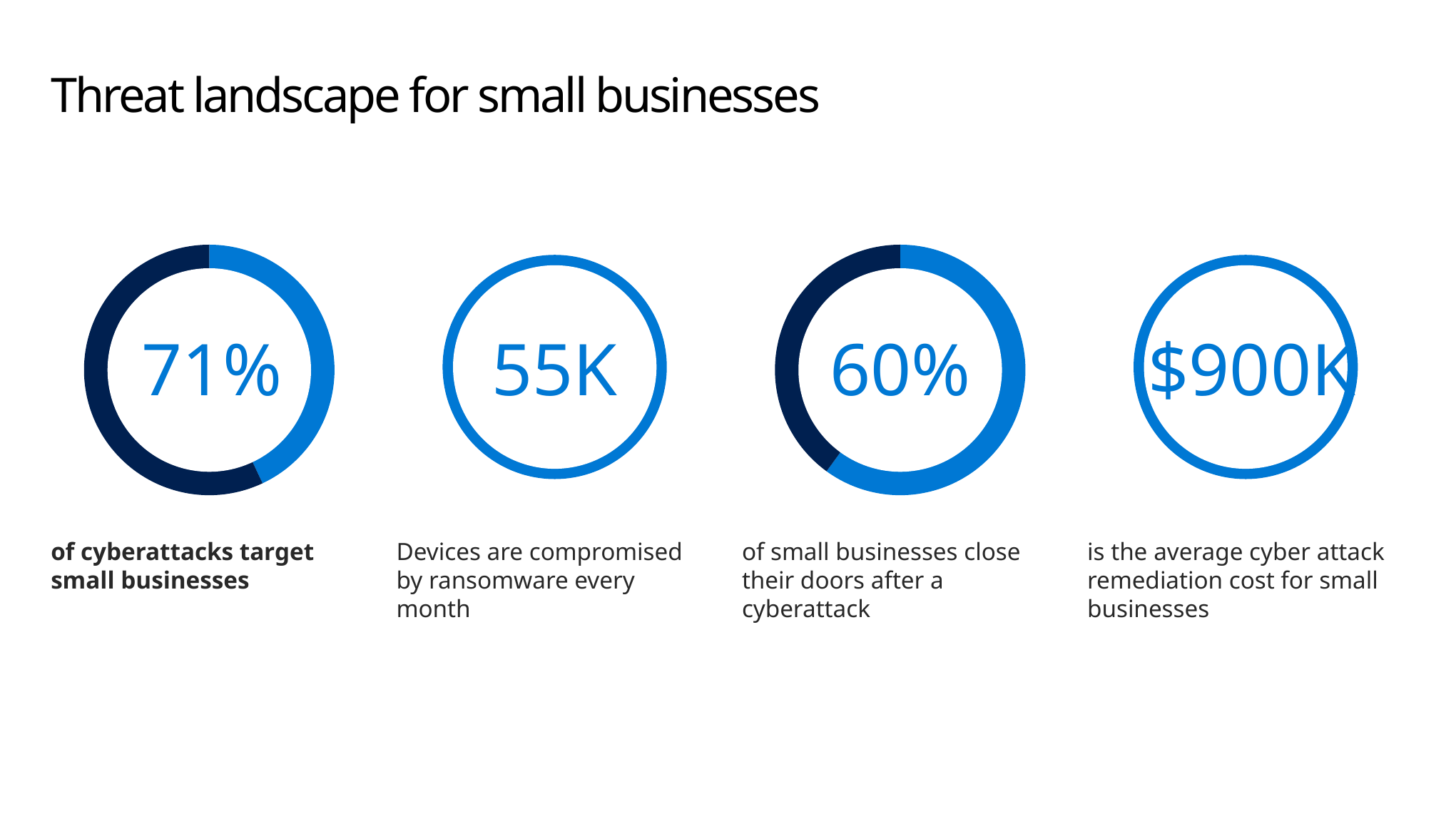
What value is shown in the centre of the first (leftmost) donut chart? 71% Which two of the four donut charts have a ring split into two colours (dark navy and light blue)? The first (71%) and third (60%) charts What kind of chart is used for each of the four statistics on the slide? Donut chart What value is shown in the centre of the third donut chart, about small businesses closing their doors after a cyberattack? 60% Is the value in the first donut chart greater or less than 50%? greater What is the title of the slide containing the four donut charts? Threat landscape for small businesses How many donut charts are shown on the slide? 4 What value is shown in the centre of the second donut chart, about devices compromised by ransomware every month? 55K What percentage of cyberattacks target small businesses, according to the first chart? 71% What value is shown in the centre of the fourth (rightmost) donut chart, the average cyber attack remediation cost for small businesses? $900K What is the difference in percentage points between the value in the first chart (71%) and the value in the third chart (60%)? 11 percentage points Which is larger: the percentage of cyberattacks that target small businesses (first chart) or the percentage of small businesses that close after a cyberattack (third chart)? The percentage of cyberattacks that target small businesses (71%)